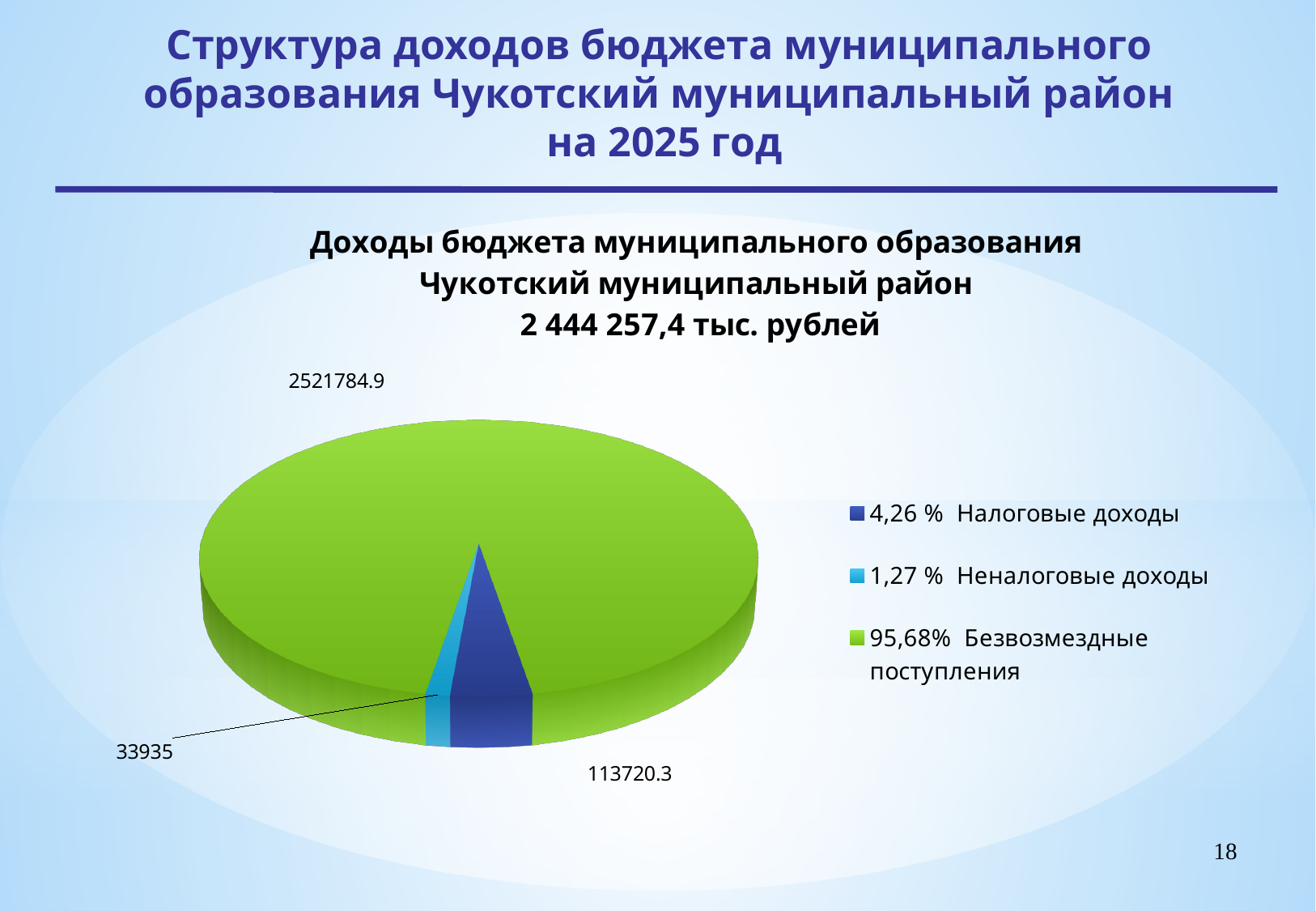
Which category has the smallest slice of the pie? Неналоговые доходы What kind of chart is shown on the slide? Pie chart Which is larger: the value for Налоговые доходы or the value for Неналоговые доходы? Налоговые доходы Which category has the largest slice of the pie? Безвозмездные поступления What is the value shown for Налоговые доходы? 113720.3 How many categories does the pie chart have? 3 What is the value shown for Неналоговые доходы? 33935 What is the difference between the values for Налоговые доходы and Неналоговые доходы? 79785.3 What share of the pie do Налоговые доходы make up, according to the legend? 4,26 % What share of the pie do Безвозмездные поступления make up, according to the legend? 95,68% What colour is the slice for Безвозмездные поступления? Green What is the value shown for Безвозмездные поступления? 2521784.9